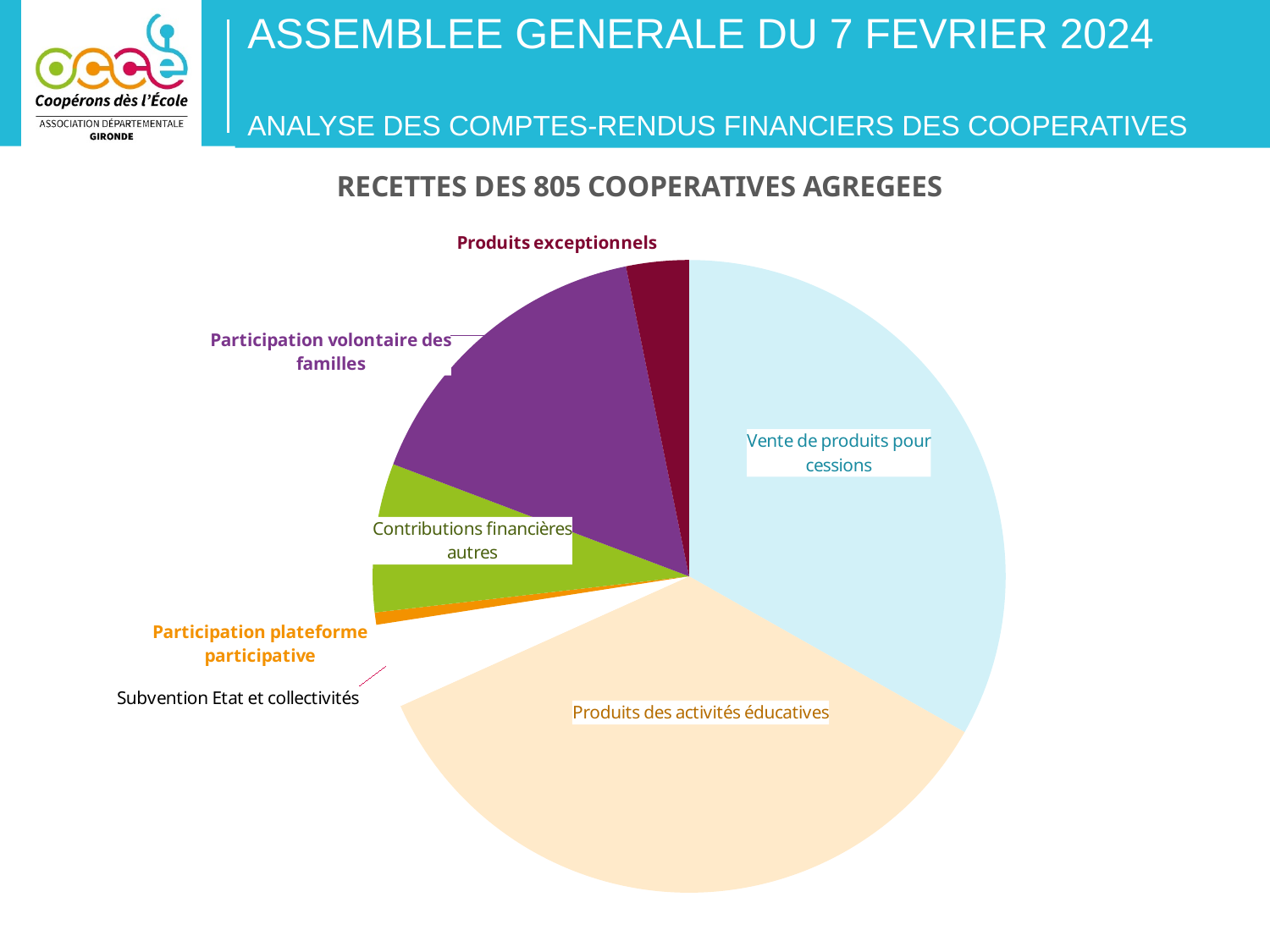
Which slice is larger: Participation volontaire des familles or Produits exceptionnels? Participation volontaire des familles Which category has the smallest slice of the pie? Participation plateforme participative How many slices does the pie chart have? 7 Which slice is larger: Contributions financières autres or Produits exceptionnels? Contributions financières autres Which slice is larger: Participation volontaire des familles or Contributions financières autres? Participation volontaire des familles What kind of chart is shown on the slide? pie chart What colour is the slice for Produits exceptionnels? dark red What is the title of the pie chart? RECETTES DES 805 COOPERATIVES AGREGEES